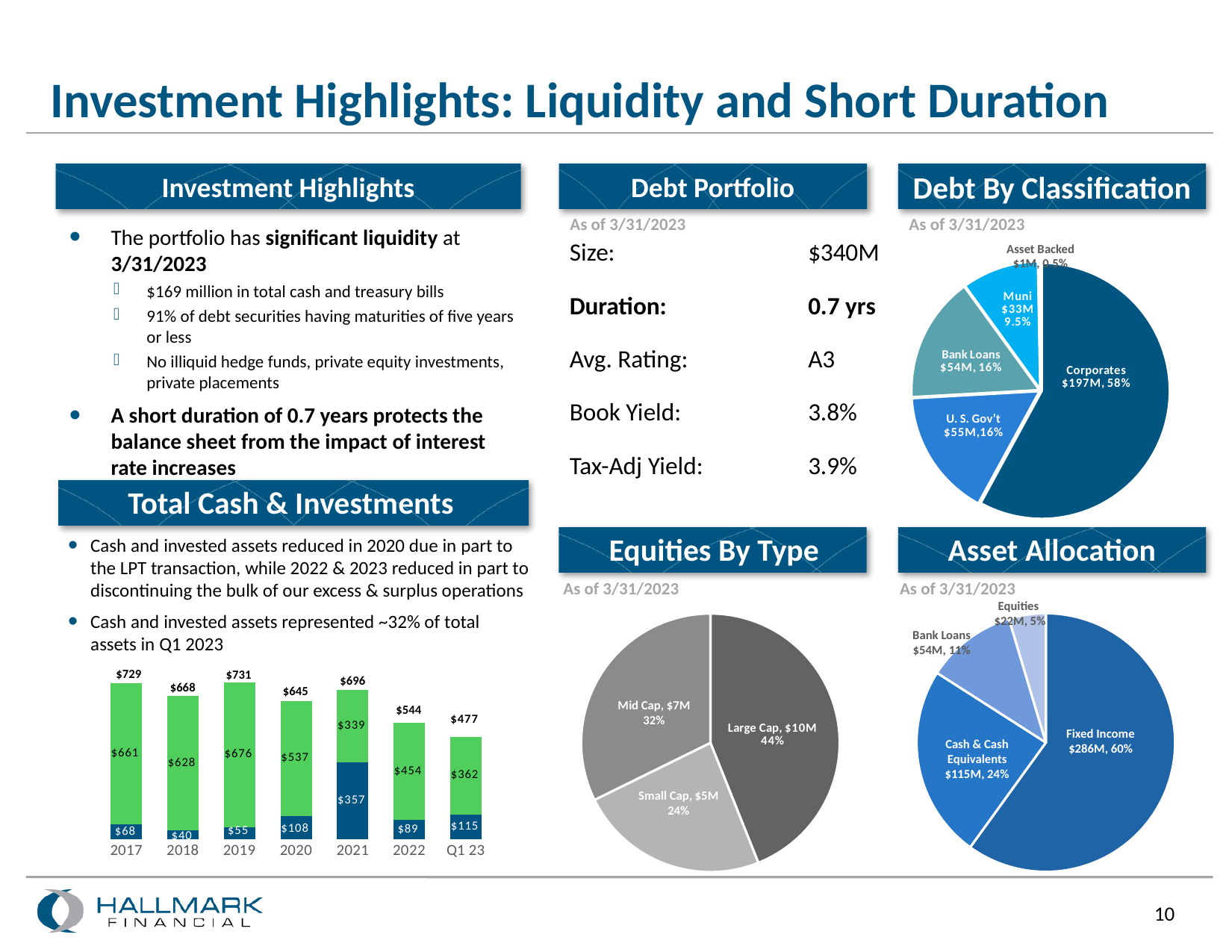
In the Total Cash & Investments chart, what is the value of the dark blue segment for 2021? $357 In the Debt By Classification chart, what is the value for Corporates? $197M, 58% In the Debt By Classification chart, which category has the smallest share? Asset Backed In the Asset Allocation chart, is Fixed Income or Cash & Cash Equivalents larger? Fixed Income In the Total Cash & Investments chart, which year has the lowest total? Q1 23 In the Total Cash & Investments chart, what is the total for 2019? $731 In the Total Cash & Investments chart, how many periods are shown on the x axis? 7 In the Equities By Type chart, what is the difference in value between Mid Cap and Small Cap? $2M In the Equities By Type chart, which category is largest? Large Cap In the Total Cash & Investments chart, what is the difference between the 2017 total and the 2018 total? $61 What type of chart is the Total Cash & Investments chart? Stacked bar chart In the Debt By Classification chart, what share of the pie is Muni? 9.5%